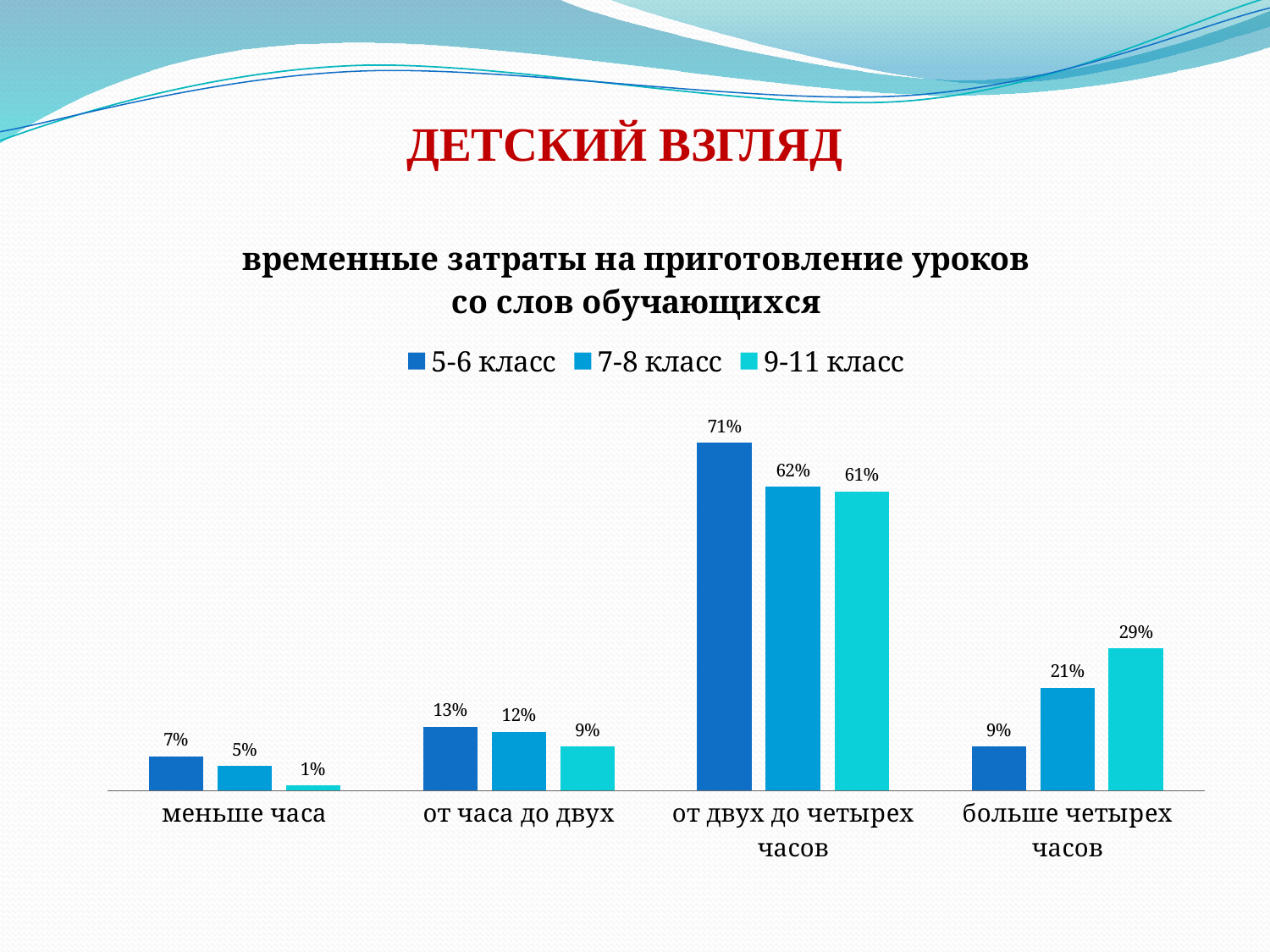
What is the value for 7-8 класс in the category 'больше четырех часов'? 21% How many series does the legend list? 3 What is the value for 5-6 класс in the category 'от двух до четырех часов'? 71% Which category has the lowest value for 5-6 класс? меньше часа What kind of chart is shown on the slide? bar chart Which category has the highest value for 9-11 класс? от двух до четырех часов How many categories are shown on the x axis? 4 What is the title of the chart? временные затраты на приготовление уроков со слов обучающихся What is the difference between the 5-6 класс and 9-11 класс values in the category 'больше четырех часов'? 20% Which is larger in the category 'от часа до двух': the value for 5-6 класс or for 9-11 класс? 5-6 класс Which series is shown in the lightest (cyan) colour in the legend? 9-11 класс What is the value for 9-11 класс in the category 'меньше часа'? 1%